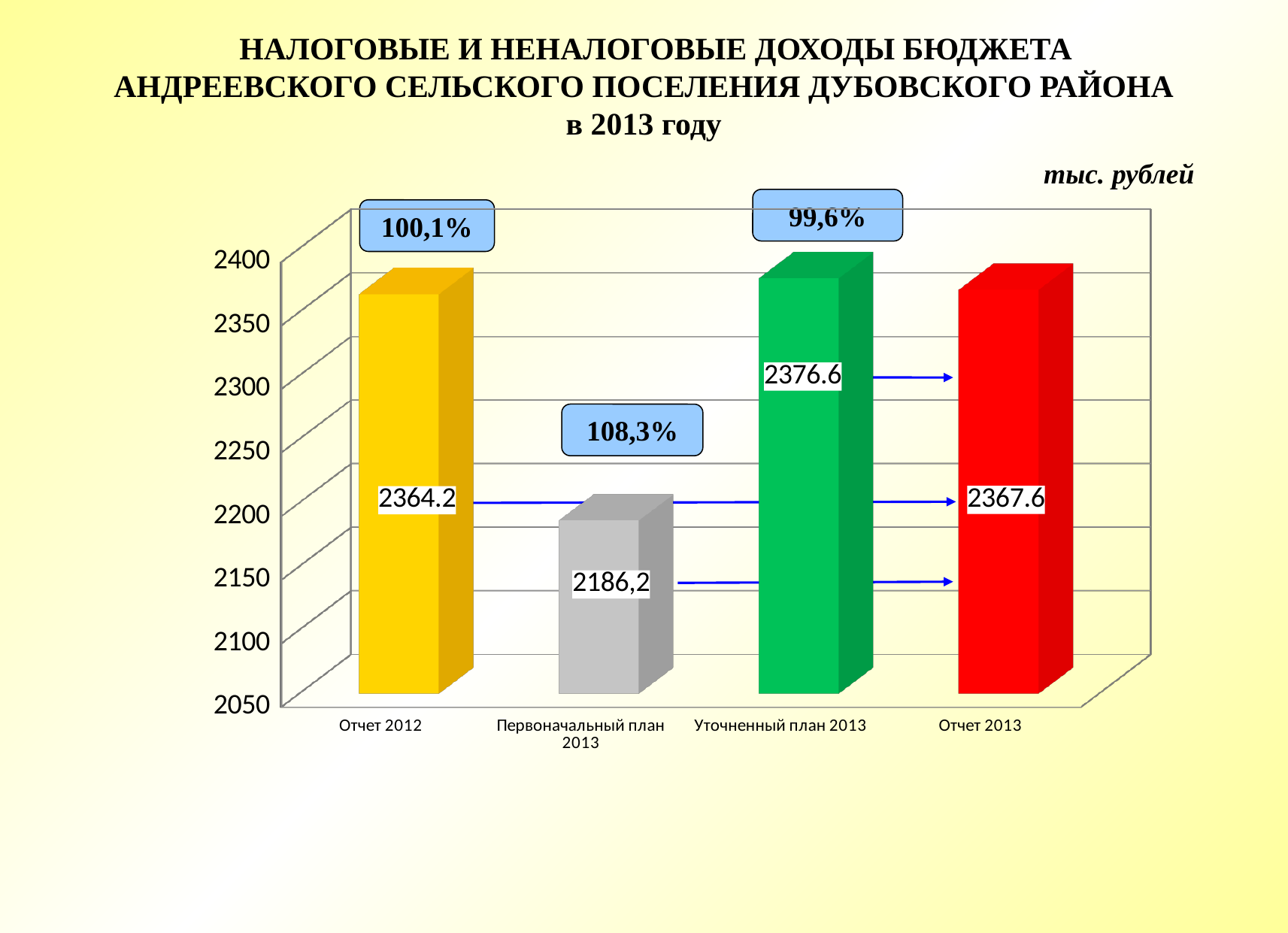
Which is larger, the value for Отчет 2012 or the value for Первоначальный план 2013? Отчет 2012 Which category has the highest value? Уточненный план 2013 Is the value for Первоначальный план 2013 greater or less than 2200? less What is the value for Первоначальный план 2013? 2186,2 What unit of measurement is indicated for the chart values? тыс. рублей Which category has the lowest value? Первоначальный план 2013 What is the difference between the values for Уточненный план 2013 and Первоначальный план 2013? 190.4 How many categories are shown on the x axis? 4 What is the value for Уточненный план 2013? 2376.6 What is the difference between the values for Отчет 2013 and Отчет 2012? 3.4 What is the value for Отчет 2012? 2364.2 What is the value for Отчет 2013? 2367.6